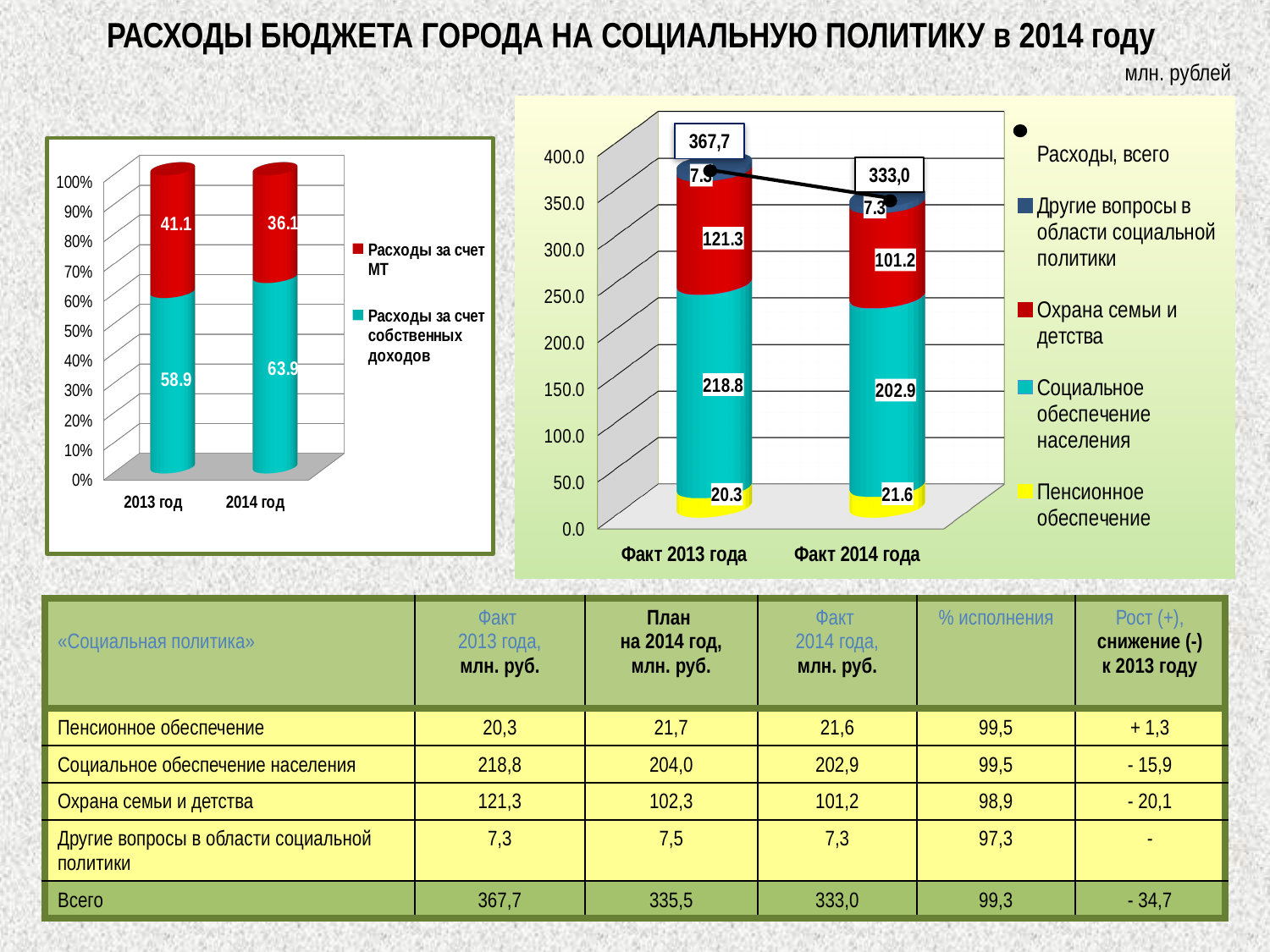
In the left chart, how many series does the legend list? 2 In the left chart, what is the value of 'Расходы за счет собственных доходов' for 2014 год? 63.9 In the right chart, what is the 'Расходы, всего' value for Факт 2014 года? 333,0 In the left chart, does the share of 'Расходы за счет МТ' rise or fall from 2013 год to 2014 год? fall In the right chart, is 'Пенсионное обеспечение' larger for Факт 2013 года or Факт 2014 года? Факт 2014 года What kind of chart is the right chart? stacked bar chart with a line In the right chart, what is the difference between 'Социальное обеспечение населения' for Факт 2013 года and Факт 2014 года? 15.9 In the left chart, what is the value of 'Расходы за счет МТ' for 2013 год? 41.1 In the right chart, which series has the largest value for Факт 2013 года? Социальное обеспечение населения In the right chart, what is the value of 'Социальное обеспечение населения' for Факт 2014 года? 202.9 In the right chart, what is the value of 'Охрана семьи и детства' for Факт 2013 года? 121.3 In the right chart, which series has the smallest value for Факт 2014 года? Другие вопросы в области социальной политики